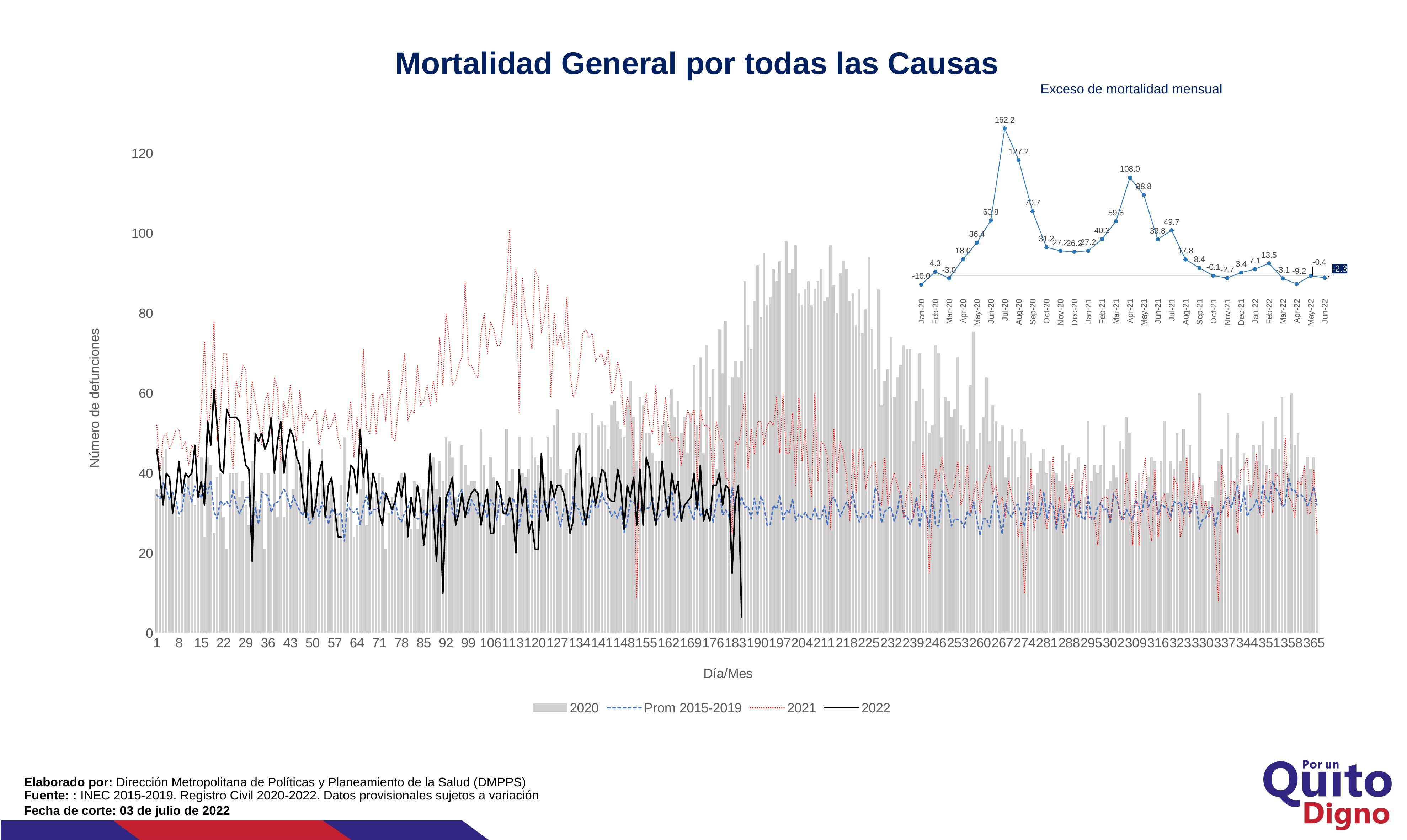
In the 'Exceso de mortalidad mensual' chart, what is the value for Jul-20? 162.2 In the 'Exceso de mortalidad mensual' chart, do the values rise or fall from Jul-20 to Dec-20? fall In the 'Exceso de mortalidad mensual' chart, what is the difference between the values for Jul-20 and Aug-20? 35.0 How many monthly data points are plotted in the 'Exceso de mortalidad mensual' chart? 30 In the 'Exceso de mortalidad mensual' chart, which month has the lowest value? Jan-20 How many series does the legend of the 'Mortalidad General por todas las Causas' chart list? 4 What is the y-axis label of the 'Mortalidad General por todas las Causas' chart? Número de defunciones In the 'Exceso de mortalidad mensual' chart, which month has the highest value? Jul-20 In the 'Exceso de mortalidad mensual' chart, which is larger, the value for Apr-21 or May-21? Apr-21 What kind of chart is the 'Exceso de mortalidad mensual' chart? line chart In the 'Exceso de mortalidad mensual' chart, what is the value for Jun-22? -2.3 In the 'Exceso de mortalidad mensual' chart, what is the value for Apr-21? 108.0